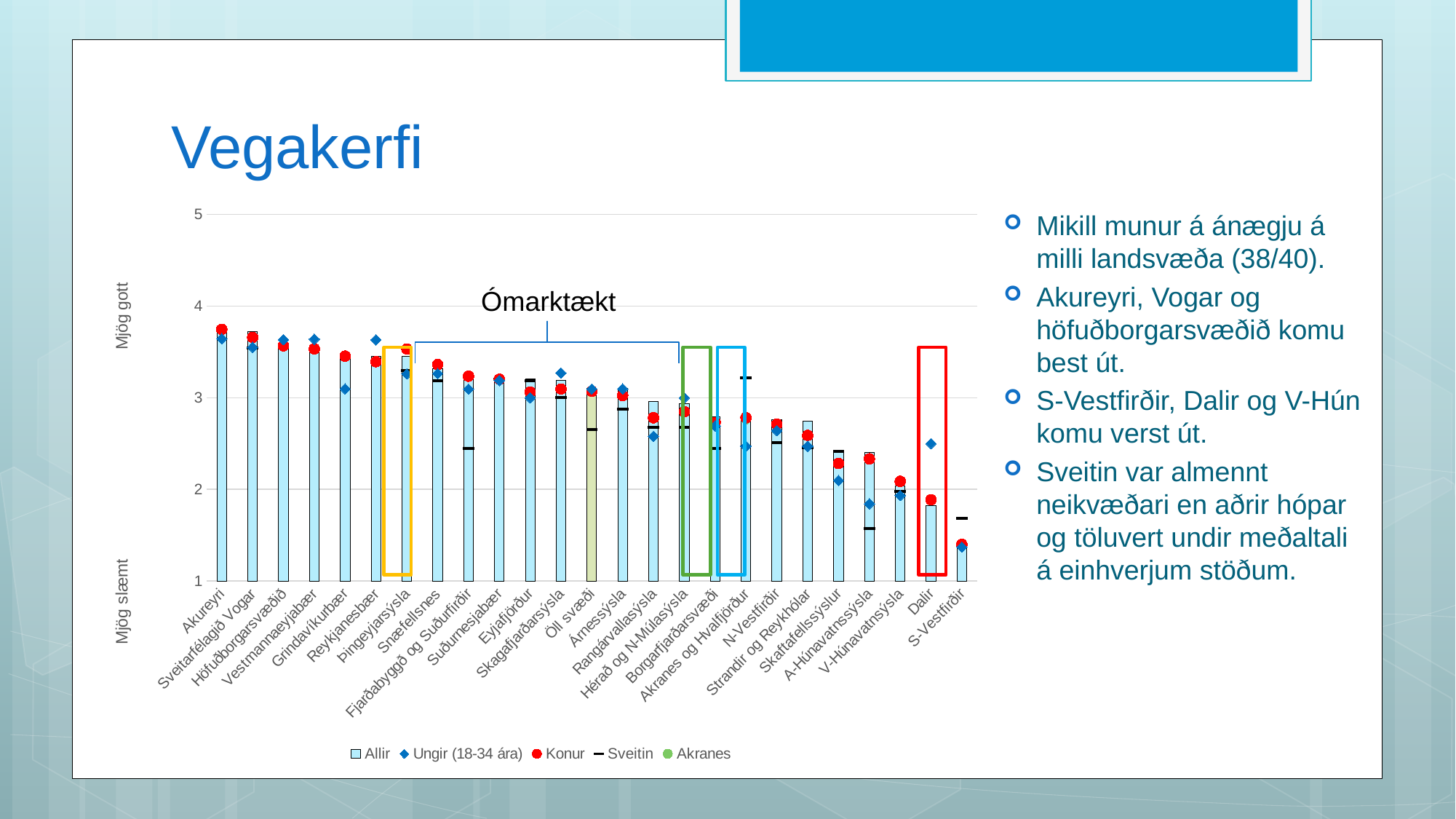
Which has the larger 'Allir' value, Akureyri or Dalir? Akureyri Is the 'Allir' value for Höfuðborgarsvæðið greater or less than 3? greater What is the title of the slide containing the chart? Vegakerfi Do the 'Allir' bar values generally rise or fall from left to right along the x axis? fall Is the 'Allir' value for Akureyri greater or less than 3? greater Which category has the lowest 'Allir' bar in the chart? S-Vestfirðir Is the 'Allir' value for S-Vestfirðir greater or less than 2? less How many series does the chart legend list? 5 What annotation text is written above the bracketed group of bars in the middle of the chart? Ómarktækt How many categories (regions) are shown along the x axis of the chart? 25 What kind of chart is shown on the slide? bar chart